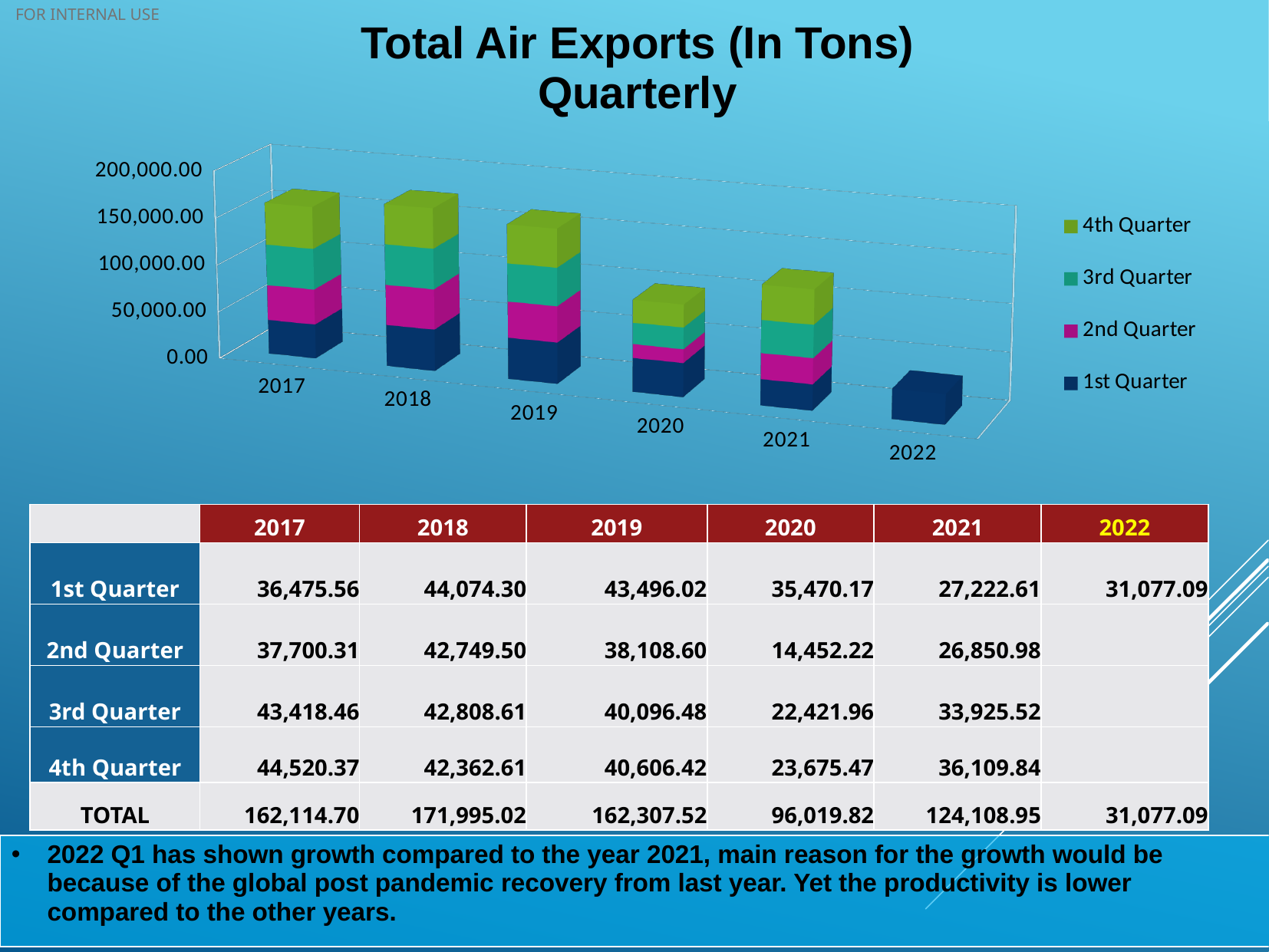
What is the total of the stacked bar for 2018? 171,995.02 How many series does the chart legend list? 4 Which year has the shortest stacked bar in the chart? 2022 What is the difference between the 1st Quarter value for 2022 and the 1st Quarter value for 2021? 3,854.48 What is the 4th Quarter value for 2021? 36,109.84 Which is larger, the 2nd Quarter value for 2020 or the 2nd Quarter value for 2021? 2021 Which year has the highest total air exports? 2018 What is the 1st Quarter value for 2017? 36,475.56 Do the yearly totals rise or fall from 2018 to 2020? Fall Is the total for the 2020 stacked bar greater or less than 100,000.00? less What kind of chart is shown on the slide? Bar chart How many years are shown along the x axis of the chart? 6